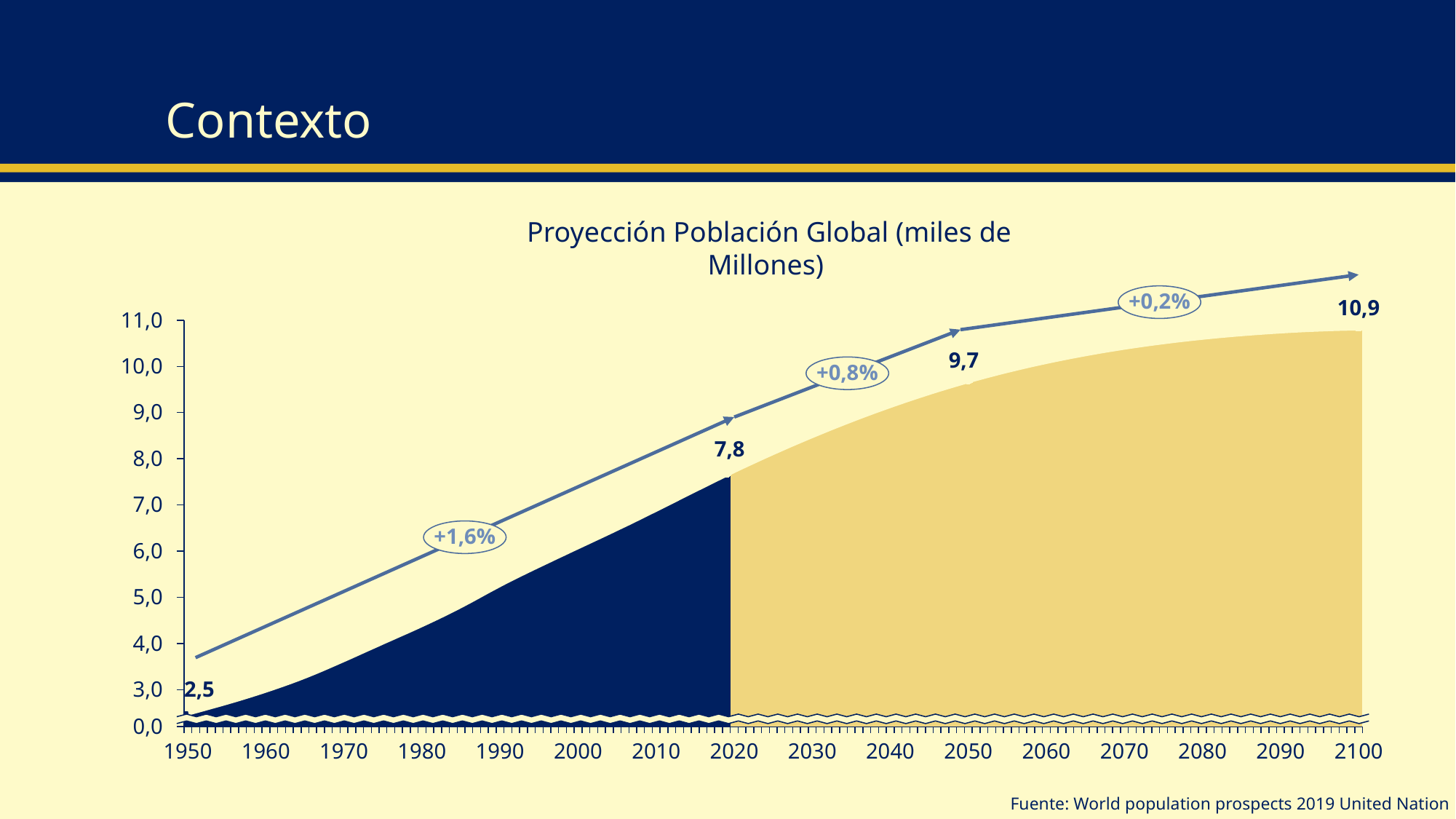
What is the difference between the labelled values for 2020 and 1950? 5,3 What is the difference between the labelled values for 2100 and 2050? 1,2 What is the labelled population value for 2020? 7,8 What is the labelled population value for 1950? 2,5 What is the labelled population value for 2050? 9,7 Does the population rise or fall from 1950 to 2100? Rise What growth rate is annotated between 2020 and 2050? +0,8% What is the title of the chart? Proyección Población Global (miles de Millones) What is the labelled population value for 2100? 10,9 Which year has the highest labelled value, 1950 or 2100? 2100 What kind of chart is shown on the slide? Area chart How many year labels are shown on the x axis? 16